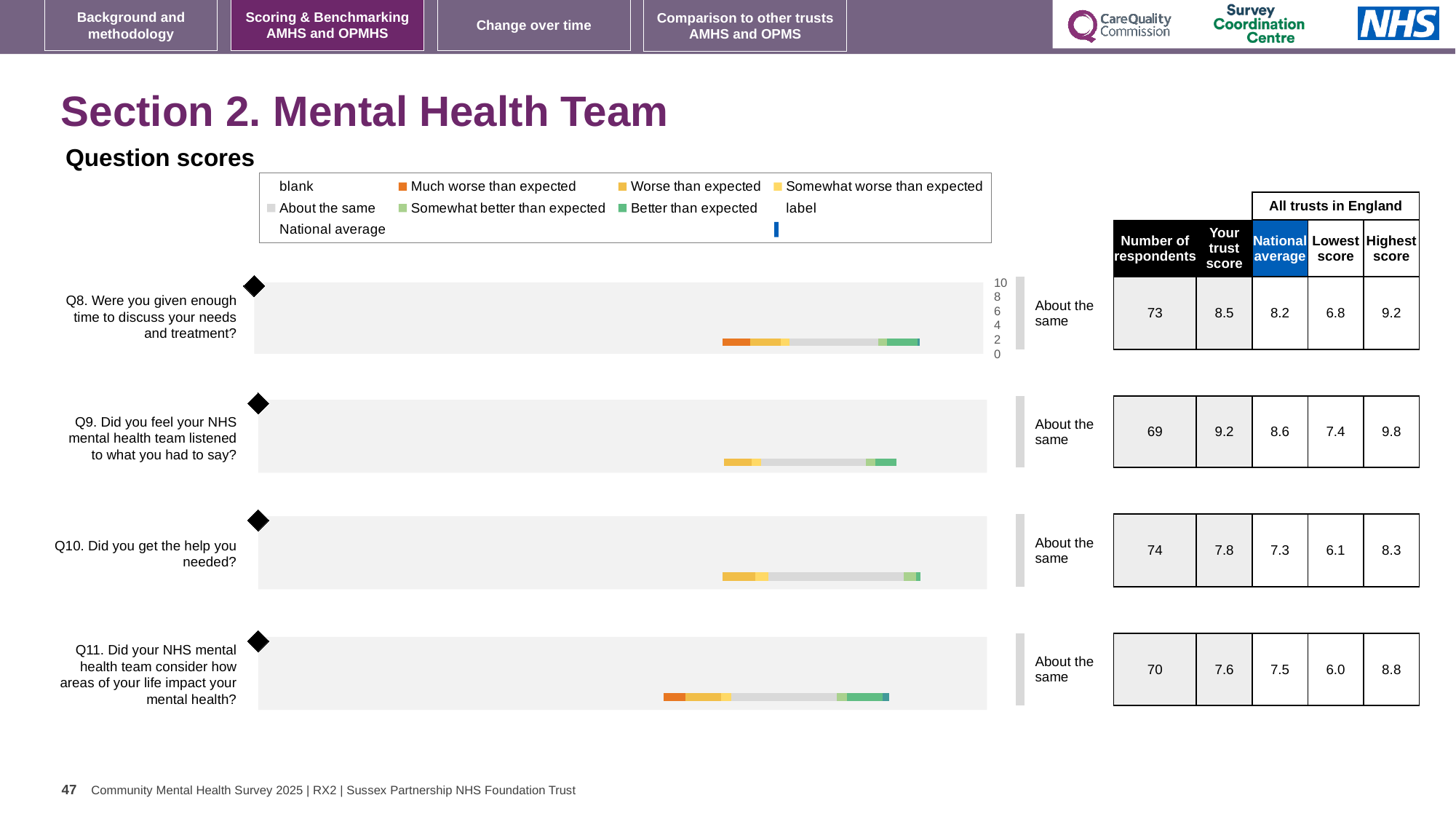
What kind of chart is used to show the question scores? bar chart Which legend entry is shown in orange? Much worse than expected How many respondents answered Q10 (Did you get the help you needed)? 74 Which question has the lowest trust score? Q11 What benchmark category is shown next to the Q8 chart? About the same Is the trust score for Q10 higher or lower than the national average for Q10? higher What is the difference between the trust score and the national average for Q9? 0.6 What is the highest score across all trusts in England for Q11? 8.8 What is the trust score for Q8 (Were you given enough time to discuss your needs and treatment)? 8.5 What is the national average for Q9 (Did you feel your NHS mental health team listened to what you had to say)? 8.6 Which question has the highest trust score? Q9 How many questions are plotted in the Question scores charts? 4